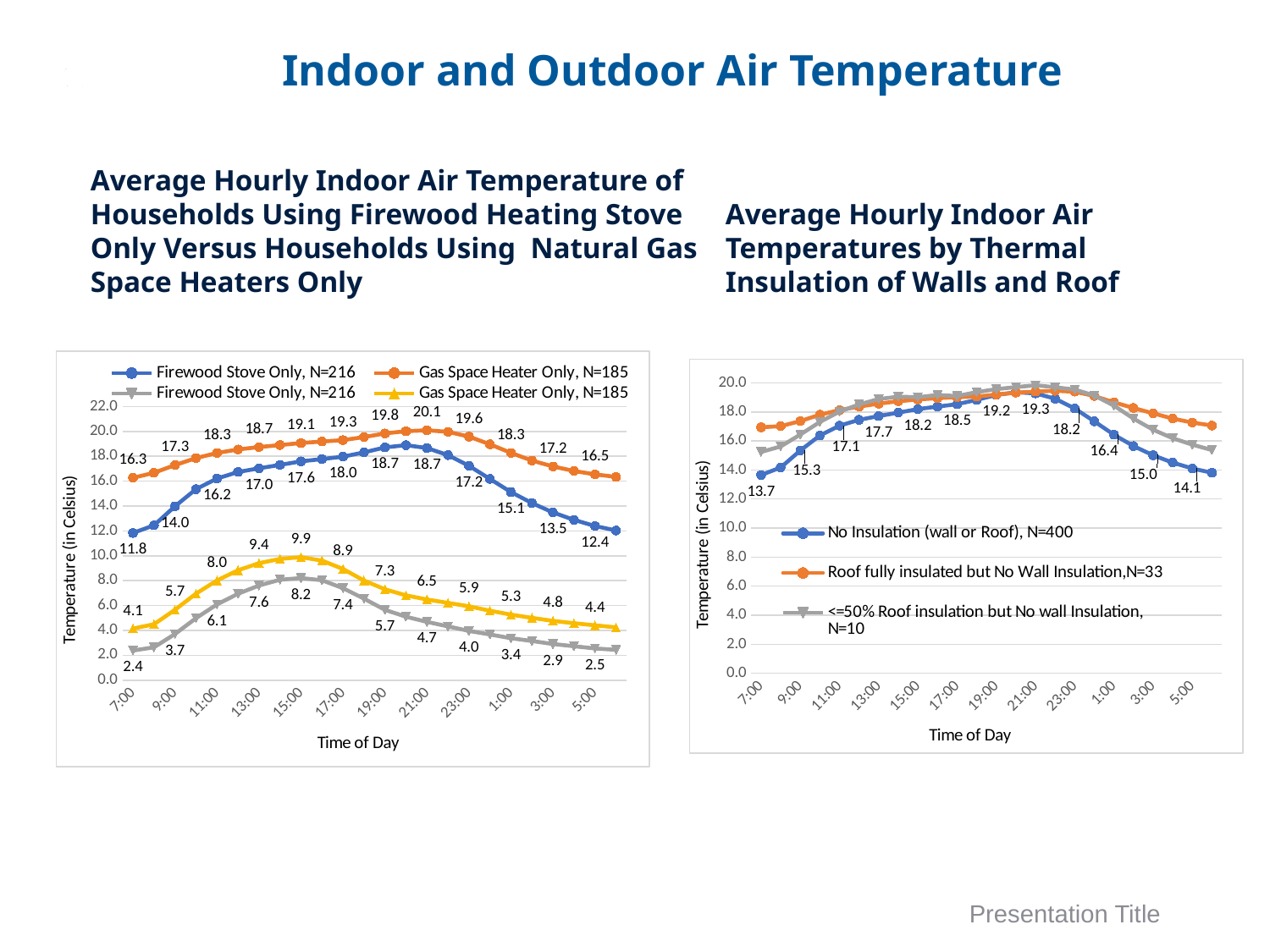
In the left chart (Firewood Heating Stove vs Natural Gas Space Heaters), what is the value of the blue Firewood Stove Only line at 7:00? 11.8 In the right chart (Thermal Insulation of Walls and Roof), is the value of the Roof fully insulated but No Wall Insulation line at 7:00 greater or less than 16.0? greater In the right chart (Thermal Insulation of Walls and Roof), how many series does the legend list? 3 In the left chart (Firewood Heating Stove vs Natural Gas Space Heaters), what is the difference between the orange Gas Space Heater Only value and the blue Firewood Stove Only value at 7:00? 4.5 In the left chart (Firewood Heating Stove vs Natural Gas Space Heaters), what is the value of the orange Gas Space Heater Only line at 21:00? 20.1 In the left chart (Firewood Heating Stove vs Natural Gas Space Heaters), how many series does the legend list? 4 In the left chart (Firewood Heating Stove vs Natural Gas Space Heaters), what is the difference between the yellow Gas Space Heater Only value and the gray Firewood Stove Only value at 15:00? 1.7 In the right chart (Thermal Insulation of Walls and Roof), is the No Insulation (wall or Roof) value larger at 7:00 or at 5:00? 5:00 What kind of chart is the right chart (Average Hourly Indoor Air Temperatures by Thermal Insulation of Walls and Roof)? Line chart In the right chart (Thermal Insulation of Walls and Roof), what is the value of the No Insulation (wall or Roof) line at 21:00? 19.3 In the left chart (Firewood Heating Stove vs Natural Gas Space Heaters), what is the highest labeled value on the yellow Gas Space Heater Only line? 9.9 In the left chart (Firewood Heating Stove vs Natural Gas Space Heaters), what is the lowest labeled value on the gray Firewood Stove Only line? 2.4